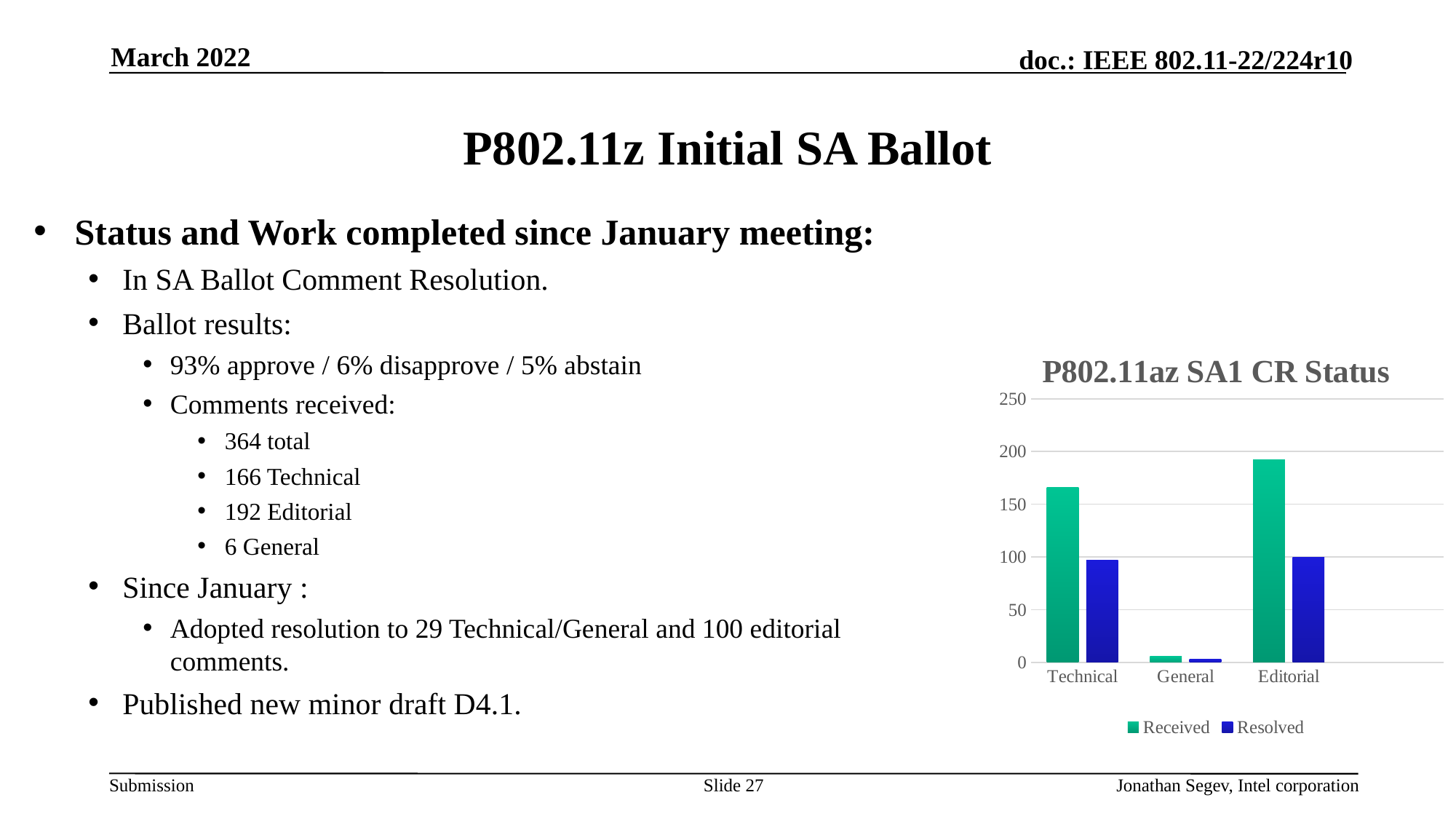
What is the title of the chart? P802.11az SA1 CR Status What kind of chart is shown on the slide? bar chart Is the Resolved value for Technical greater or less than 50? greater How many series does the chart legend list? 2 How many categories are shown on the x axis of the chart? 3 Which category has the lowest Received value? General Is the Received value for Editorial greater or less than 200? less For Technical, which is larger: the Received value or the Resolved value? Received Which category has the lowest Resolved value? General Which category has the highest Received value? Editorial Is the Received value for General greater or less than 50? less